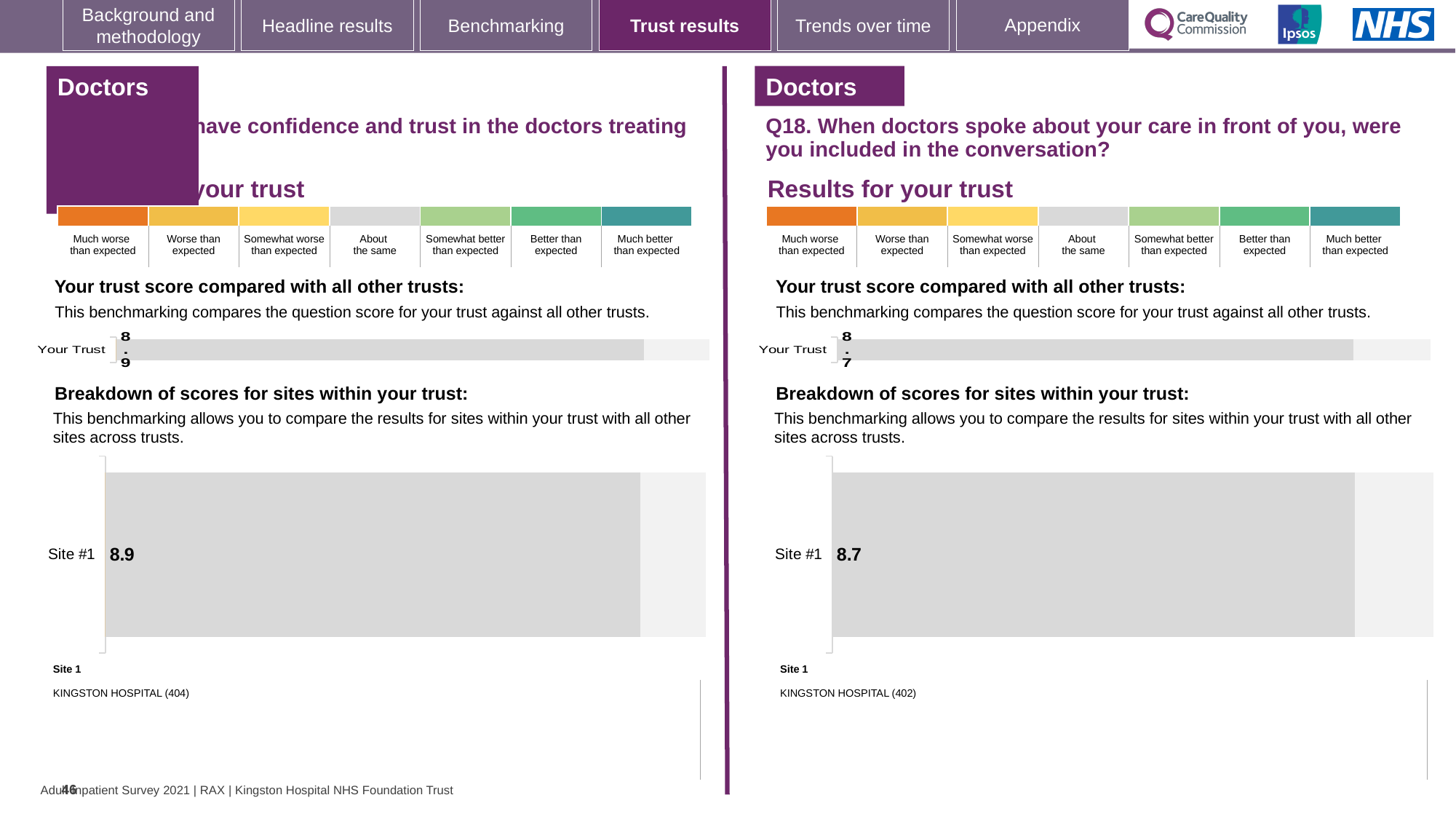
How many sites are shown in the left-hand 'Breakdown of scores for sites within your trust' chart? 1 On the right-hand side of the slide (Q18), what is the score shown for Your Trust? 8.7 In the right-hand 'Breakdown of scores for sites within your trust' chart (Q18), what is the score for Site #1? 8.7 In the left-hand 'Breakdown of scores for sites within your trust' chart, what is the score for Site #1? 8.9 Which hospital is listed as Site 1 on the right-hand side of the slide (Q18)? KINGSTON HOSPITAL (402) What type of chart is used to show the Site #1 score on the right-hand side of the slide? Bar chart On the left-hand side of the slide, what is the score shown for Your Trust? 8.9 How many sites are shown in the right-hand 'Breakdown of scores for sites within your trust' chart (Q18)? 1 What is the difference between the Site #1 score on the left-hand side and the Site #1 score on the right-hand side (Q18)? 0.2 Is the Site #1 score on the right-hand side of the slide (Q18) the same as the Your Trust score on that side? Yes, both are 8.7 Which hospital is listed as Site 1 on the left-hand side of the slide? KINGSTON HOSPITAL (404) Which is larger: the Your Trust score on the left-hand side of the slide or the Your Trust score on the right-hand side (Q18)? Left-hand side (8.9)